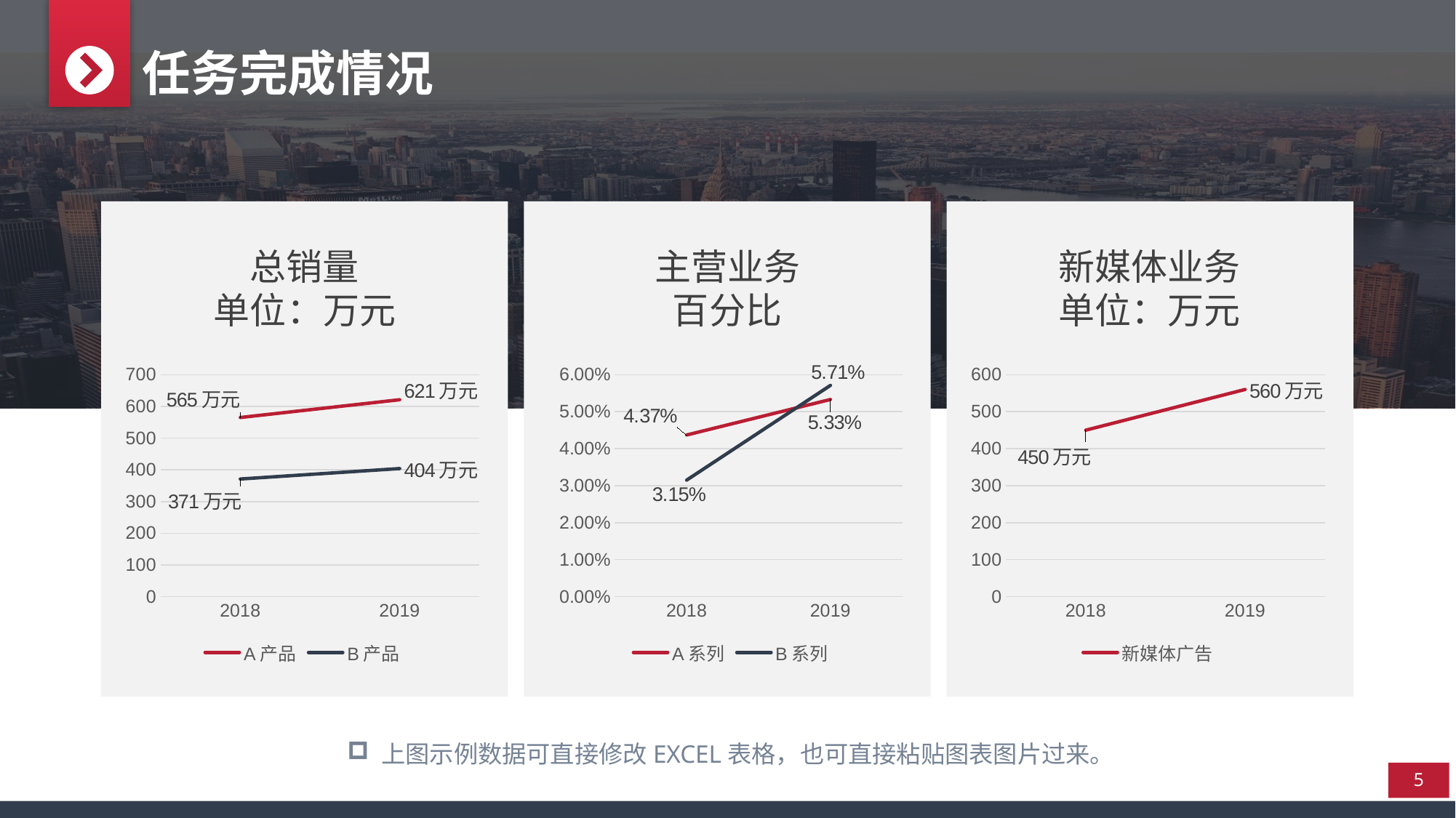
In the 总销量 chart, how many series does the legend list? 2 In the 主营业务 百分比 chart, which series has the higher value in 2019? B 系列 In the 主营业务 百分比 chart, what is the value for B 系列 in 2018? 3.15% In the 主营业务 百分比 chart, what is the value for A 系列 in 2019? 5.33% In the 总销量 chart, what is the difference between A 产品 and B 产品 in 2019? 217 万元 What kind of chart is the 新媒体业务 chart? line chart In the 总销量 chart, what is the value for A 产品 in 2019? 621 万元 How many charts are shown on the slide? 3 In the 新媒体业务 chart, what is the value for 新媒体广告 in 2018? 450 万元 In the 新媒体业务 chart, what is the difference between the 2019 and 2018 values? 110 万元 In the 总销量 chart, what is the value for B 产品 in 2018? 371 万元 In the 主营业务 百分比 chart, does B 系列 rise or fall from 2018 to 2019? rise